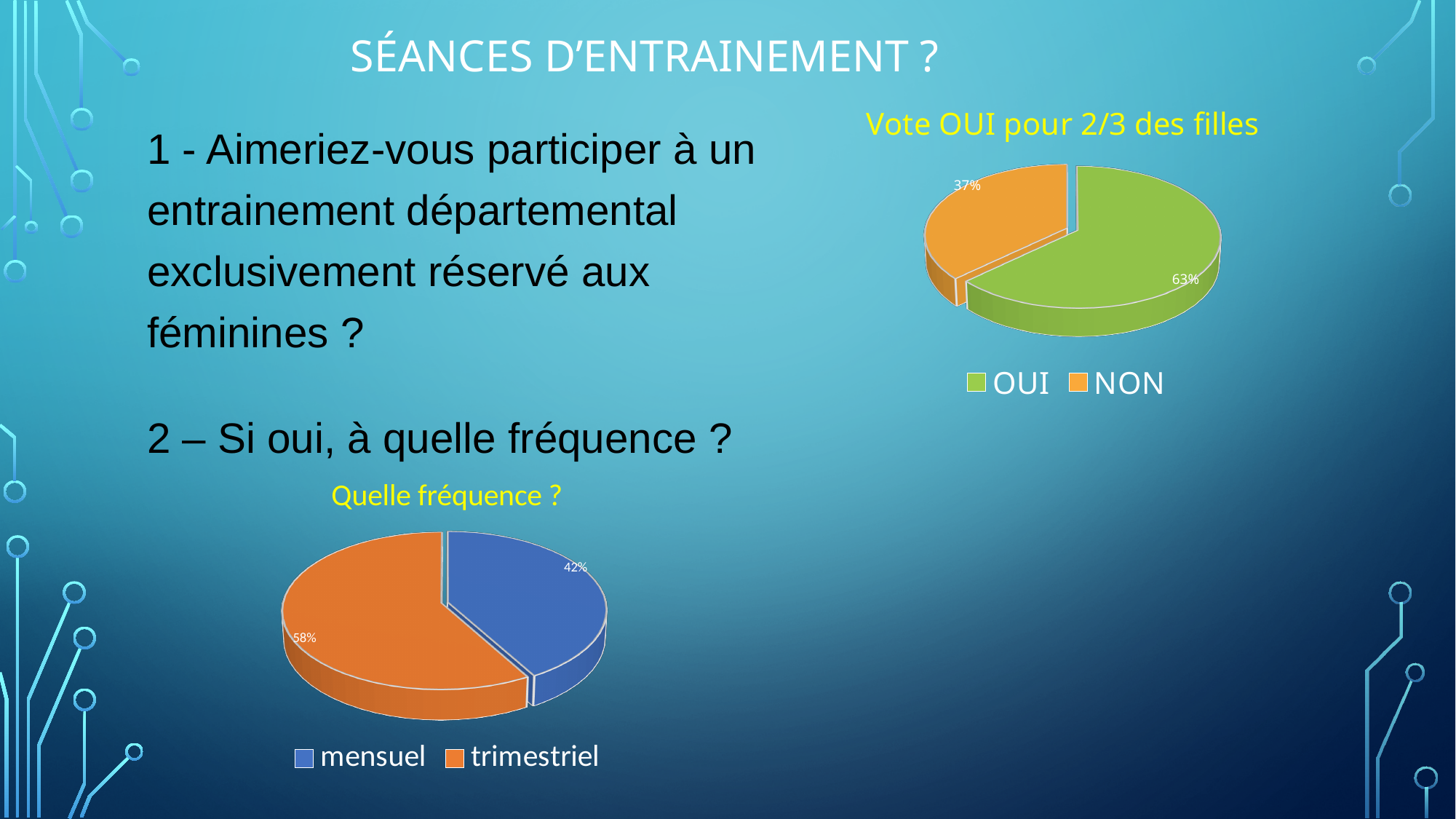
In the chart titled "Vote OUI pour 2/3 des filles", which slice is the largest? OUI In the chart titled "Vote OUI pour 2/3 des filles", what percentage is shown for NON? 37% In the chart titled "Quelle fréquence ?", which is larger, mensuel or trimestriel? trimestriel In the chart titled "Quelle fréquence ?", what colour is the trimestriel slice? Orange In the chart titled "Quelle fréquence ?", which slice is the smallest? mensuel What kind of chart is the one titled "Vote OUI pour 2/3 des filles"? Pie chart How many slices does the chart titled "Quelle fréquence ?" have? 2 In the chart titled "Vote OUI pour 2/3 des filles", what is the difference in percentage points between OUI and NON? 26 In the chart titled "Quelle fréquence ?", what percentage is shown for mensuel? 42% In the chart titled "Quelle fréquence ?", what is the difference in percentage points between trimestriel and mensuel? 16 In the chart titled "Vote OUI pour 2/3 des filles", what percentage is shown for OUI? 63% In the chart titled "Quelle fréquence ?", what percentage is shown for trimestriel? 58%